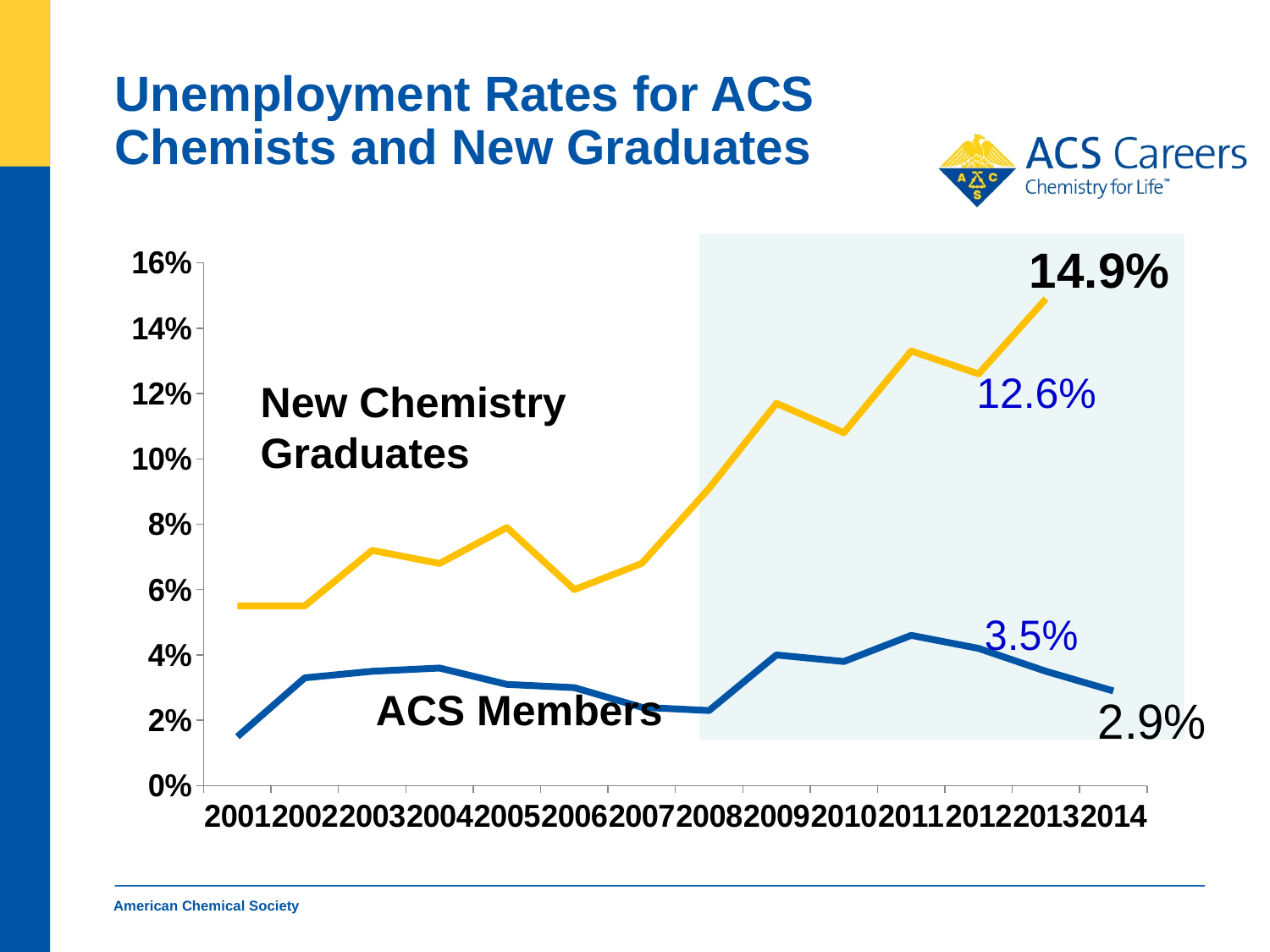
Does the unemployment rate for New Chemistry Graduates rise or fall from 2008 to 2013? rise How many data series are plotted on the chart? 2 What is the highest labeled unemployment rate for New Chemistry Graduates? 14.9% Is the unemployment rate for New Chemistry Graduates in 2001 greater or less than 6%? less Does the unemployment rate for ACS Members rise or fall from 2011 to 2014? fall What is the unemployment rate for ACS Members in 2014? 2.9% Is the unemployment rate for ACS Members in 2011 greater or less than 4%? greater What kind of chart is shown on the slide? line chart How many years are shown on the x axis? 14 Is the unemployment rate for ACS Members in 2001 greater or less than 2%? less Which series has the higher unemployment rate across all years shown? New Chemistry Graduates